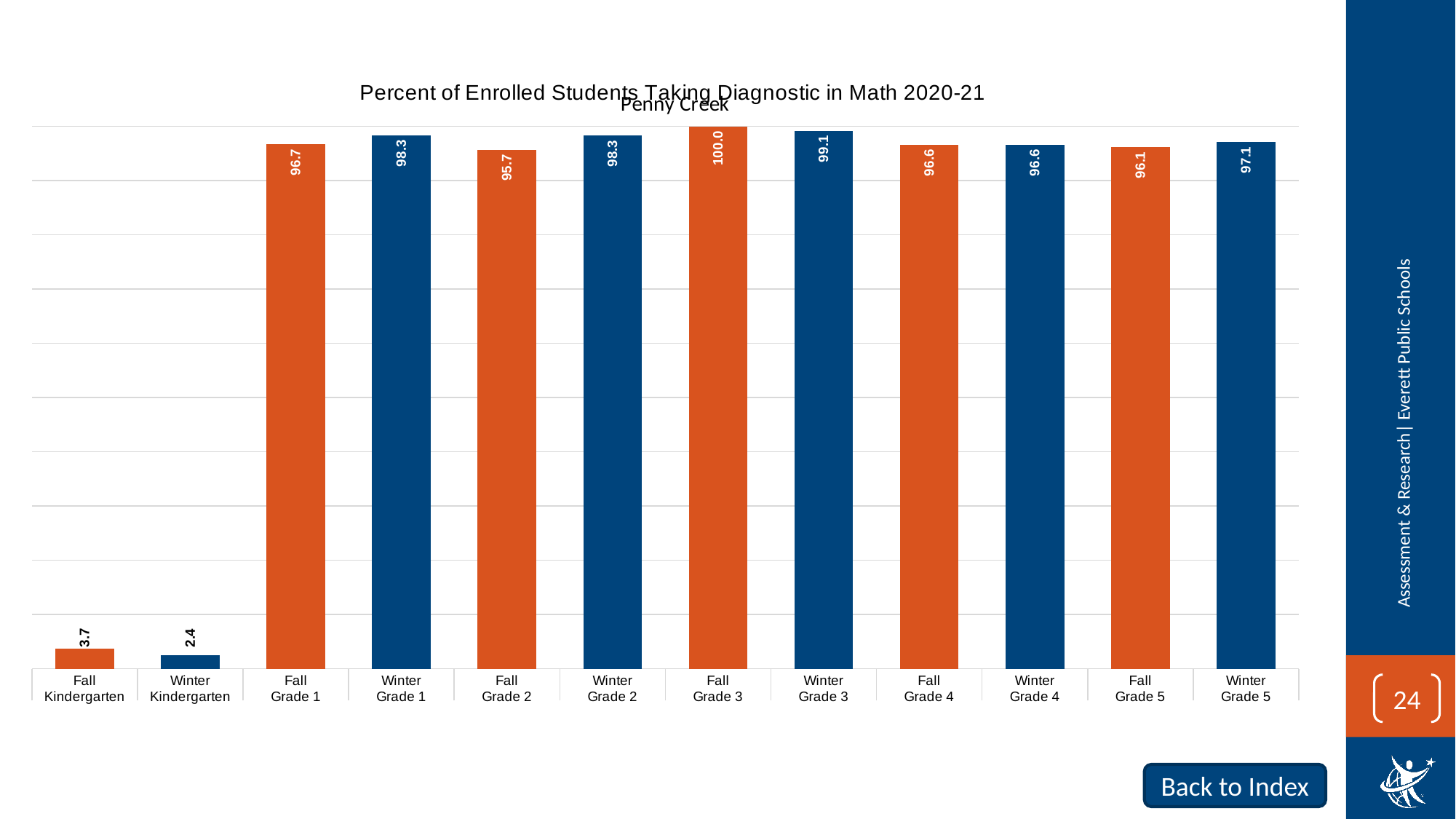
What colour are the bars for the Fall categories? orange How many categories are shown on the x axis? 12 What is the difference between the values for Winter Grade 1 and Fall Grade 1? 1.6 Which is larger, the value for Fall Grade 2 or Winter Grade 2? Winter Grade 2 What kind of chart is shown on the slide? bar chart What is the value for Fall Grade 5? 96.1 Which category has the highest value? Fall Grade 3 Which category has the lowest value? Winter Kindergarten What is the value for Fall Grade 3? 100.0 What is the value for Winter Kindergarten? 2.4 What is the difference between the values for Fall Kindergarten and Winter Kindergarten? 1.3 What is the title of the chart? Percent of Enrolled Students Taking Diagnostic in Math 2020-21